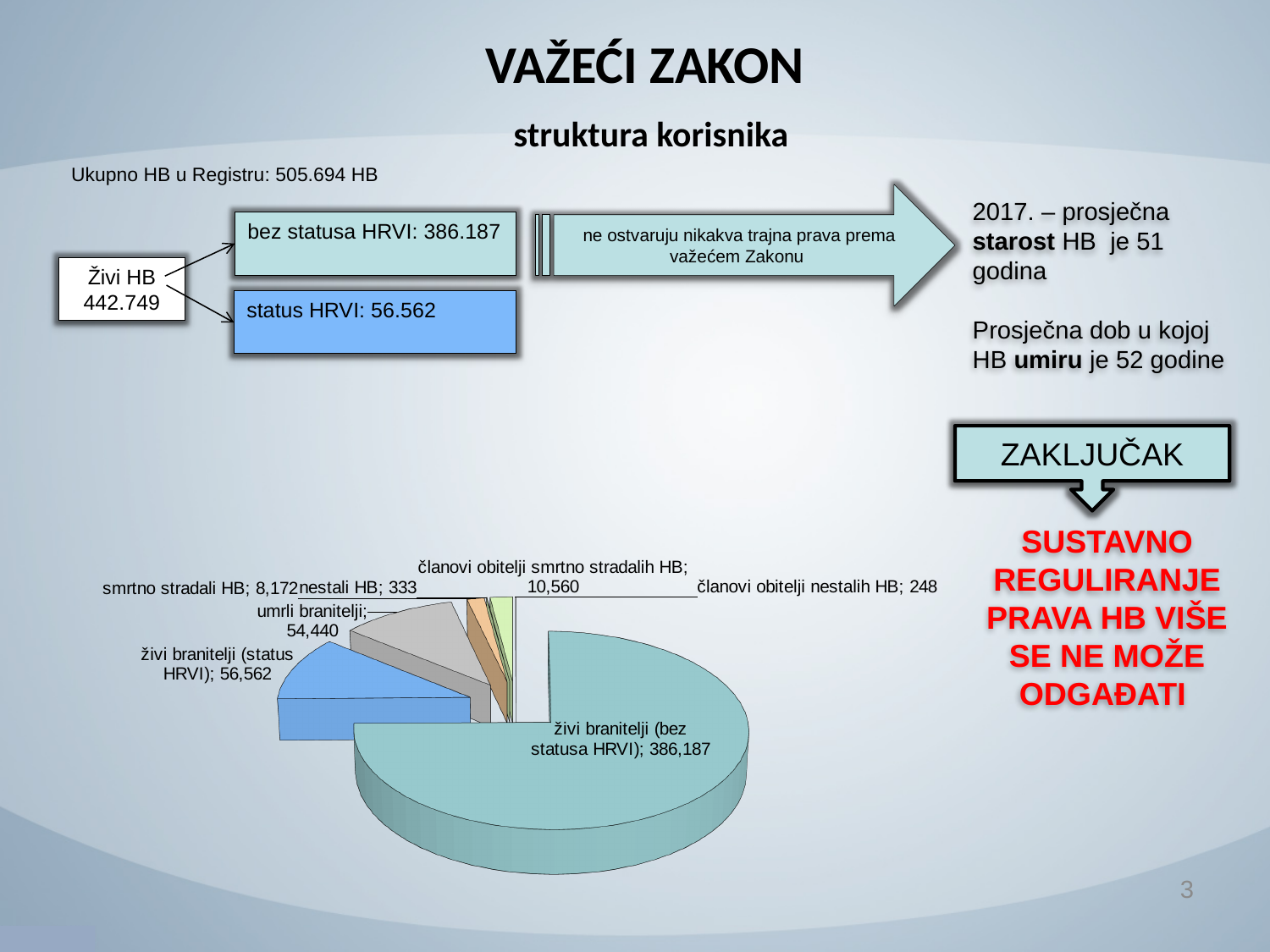
What is the value for 'nestali HB' in the pie chart? 333 What is the value for 'članovi obitelji nestalih HB' in the pie chart? 248 What is the value for 'umrli branitelji' in the pie chart? 54,440 What is the value for 'živi branitelji (status HRVI)' in the pie chart? 56,562 Which is larger in the pie chart: 'smrtno stradali HB' or 'članovi obitelji smrtno stradalih HB'? članovi obitelji smrtno stradalih HB What is the difference between 'nestali HB' and 'članovi obitelji nestalih HB' in the pie chart? 85 Which category has the smallest slice in the pie chart? članovi obitelji nestalih HB What is the value for 'živi branitelji (bez statusa HRVI)' in the pie chart? 386,187 Which category has the largest slice in the pie chart? živi branitelji (bez statusa HRVI) How many slices does the pie chart have? 7 What is the difference between 'članovi obitelji smrtno stradalih HB' and 'smrtno stradali HB' in the pie chart? 2,388 What type of chart is shown on the slide? pie chart